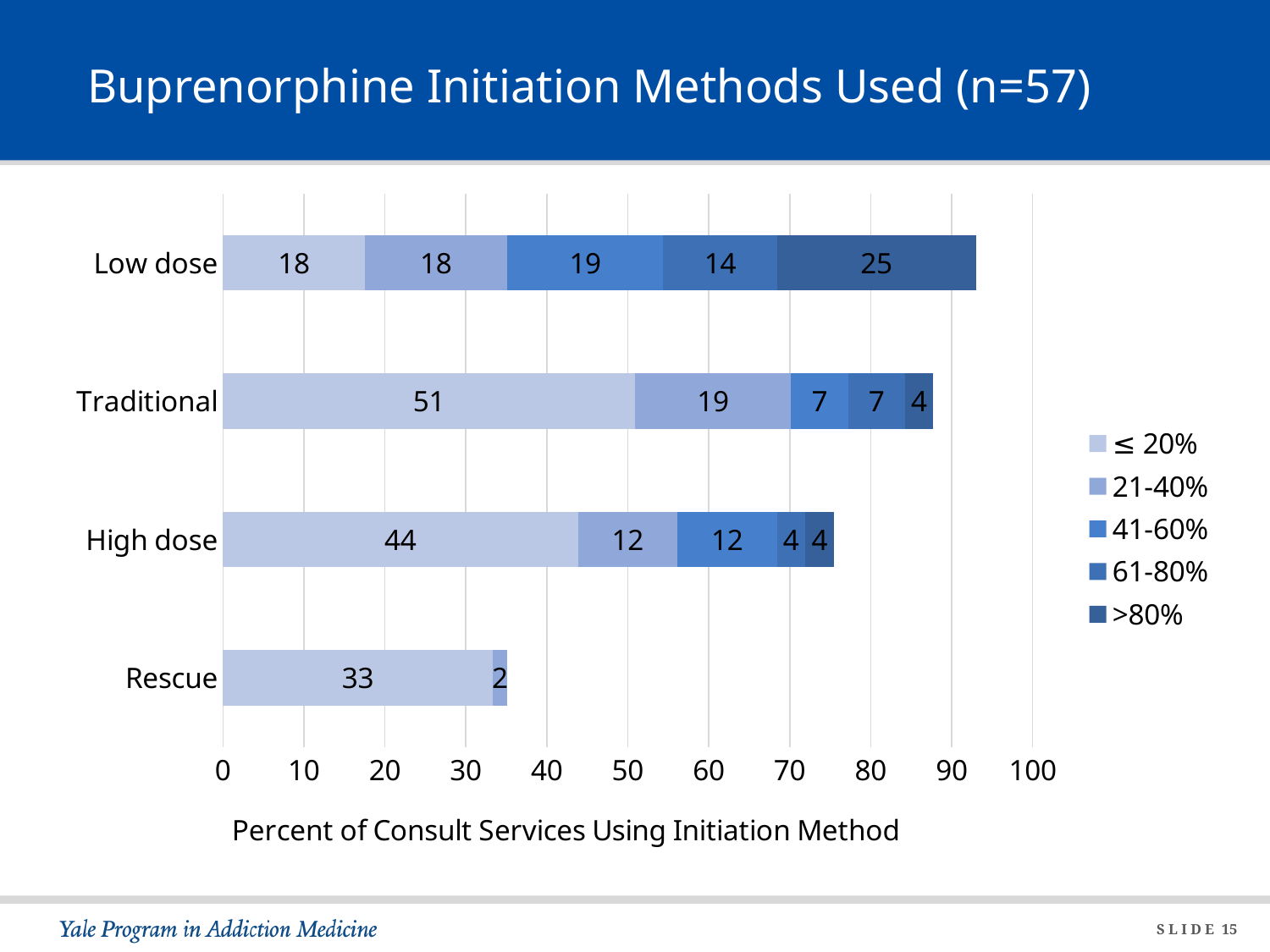
Which initiation method has the largest ≤ 20% segment? Traditional What is the difference between the ≤ 20% segment for Traditional and the ≤ 20% segment for High dose? 7 How many initiation methods (categories) are plotted on the chart? 4 How many series does the legend list? 5 What is the value of the ≤ 20% segment for Traditional? 51 What is the value of the 41-60% segment for High dose? 12 What is the value of the >80% segment for Low dose? 25 Which initiation method has the smallest total bar length? Rescue What is the value of the 21-40% segment for Rescue? 2 What is the title of the x axis? Percent of Consult Services Using Initiation Method What kind of chart is shown on the slide? Stacked bar chart What is the total of the stacked bar for Low dose? 94